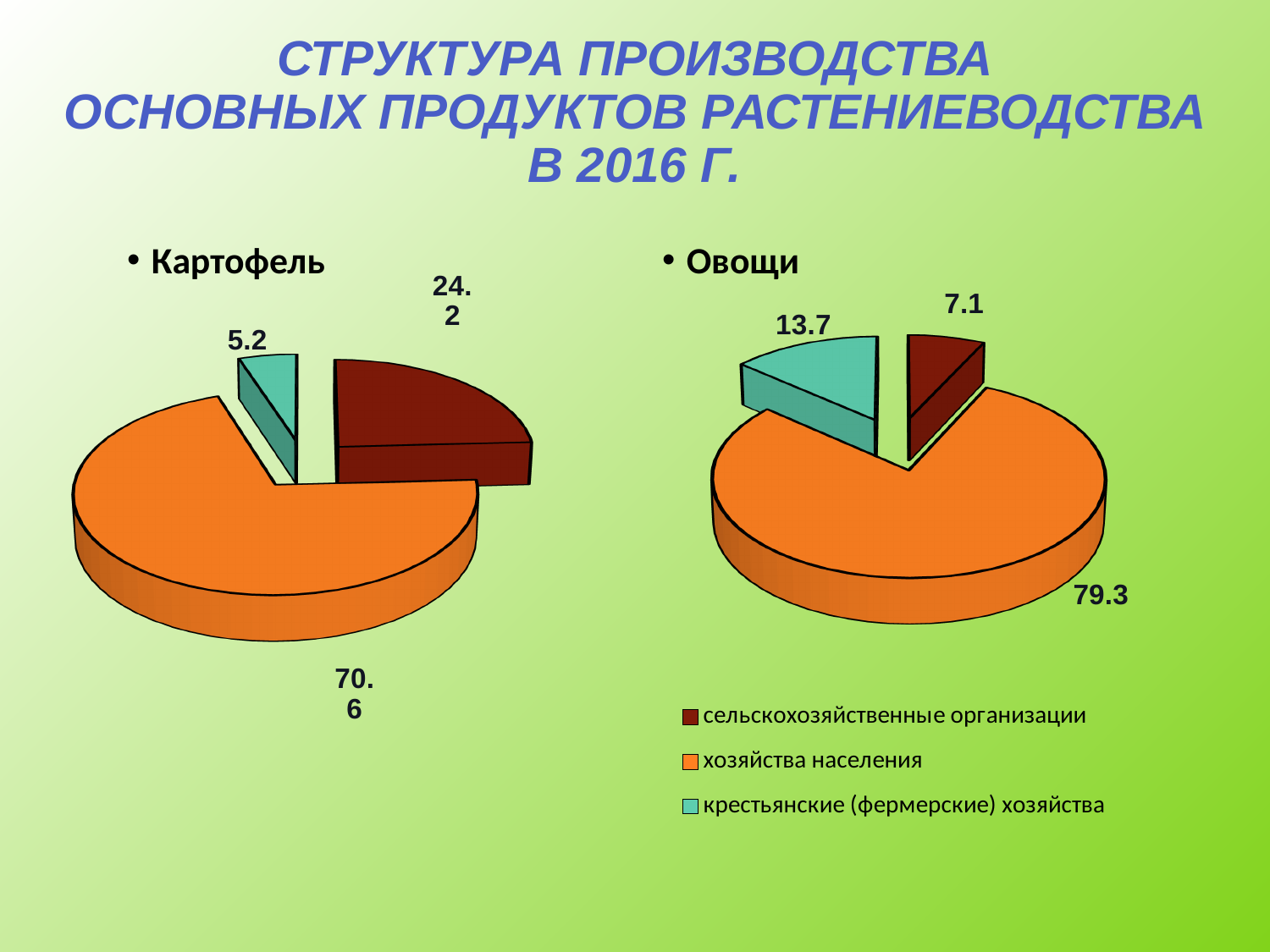
In the Картофель chart, what is the value for крестьянские (фермерские) хозяйства? 5.2 What type of chart is used for the Картофель data? pie chart In the Картофель chart, what is the value for хозяйства населения? 70.6 Which is larger: the value for сельскохозяйственные организации in the Картофель chart or in the Овощи chart? Картофель In the Картофель chart, what is the value for сельскохозяйственные организации? 24.2 In the Картофель chart, which category has the largest slice? хозяйства населения In the Картофель chart, what is the difference between the values for хозяйства населения and сельскохозяйственные организации? 46.4 In the Овощи chart, what is the value for крестьянские (фермерские) хозяйства? 13.7 How many slices does the Овощи pie chart have? 3 In the Овощи chart, which category has the smallest slice? сельскохозяйственные организации In the Овощи chart, what is the value for хозяйства населения? 79.3 How many entries does the legend list? 3